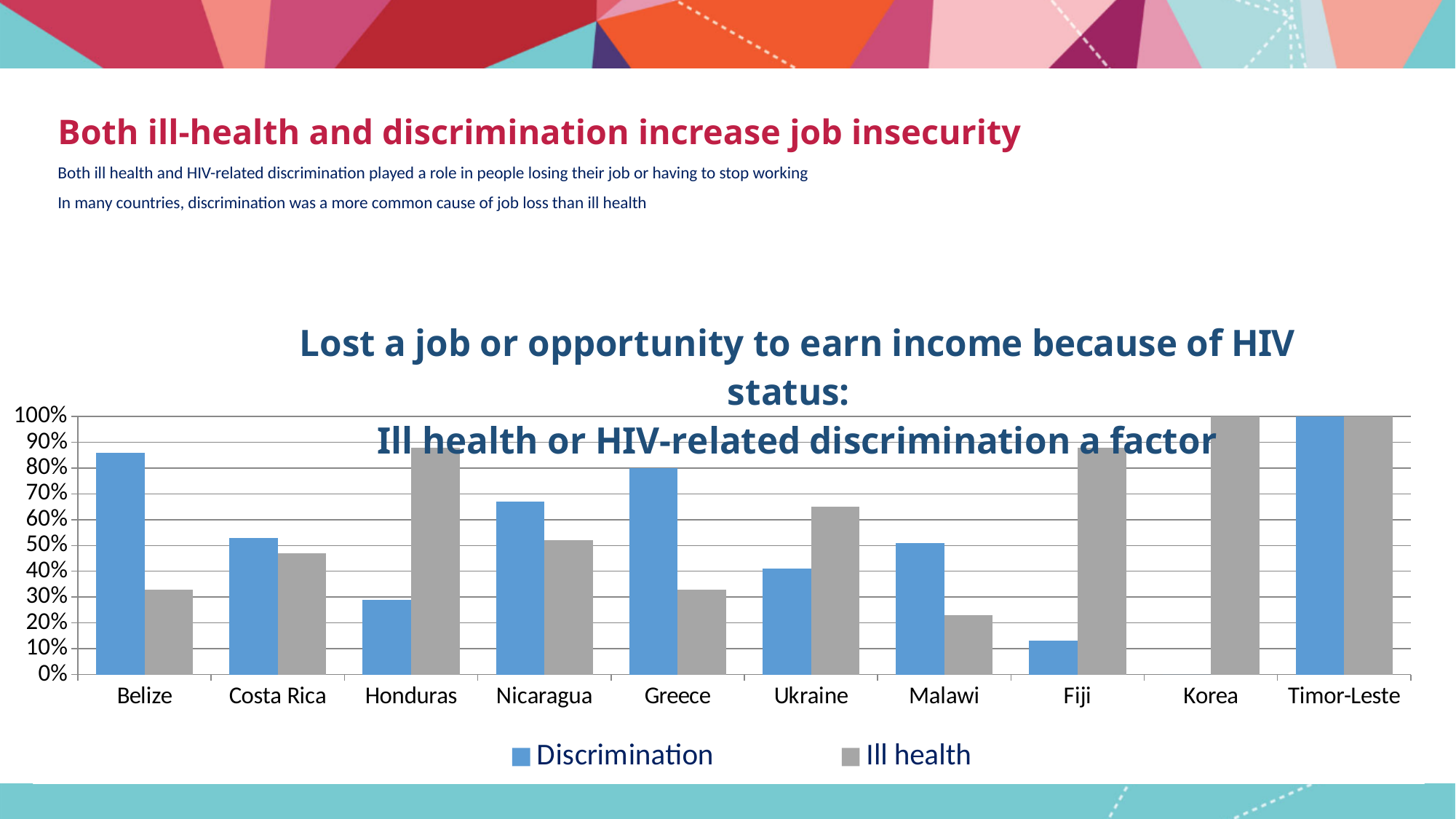
Is the Discrimination value for Belize greater or less than 80%? greater Is the Ill health value for Ukraine greater or less than 60%? greater For Greece, which is larger: the Discrimination value or the Ill health value? Discrimination What is the Ill health value for Korea? 100% What kind of chart is shown on the slide? bar chart How many countries are shown on the x axis? 10 Which series is shown in grey in the legend? Ill health What is the Discrimination value for Timor-Leste? 100% How many series does the legend list? 2 Which country has the lowest Ill health value? Malawi